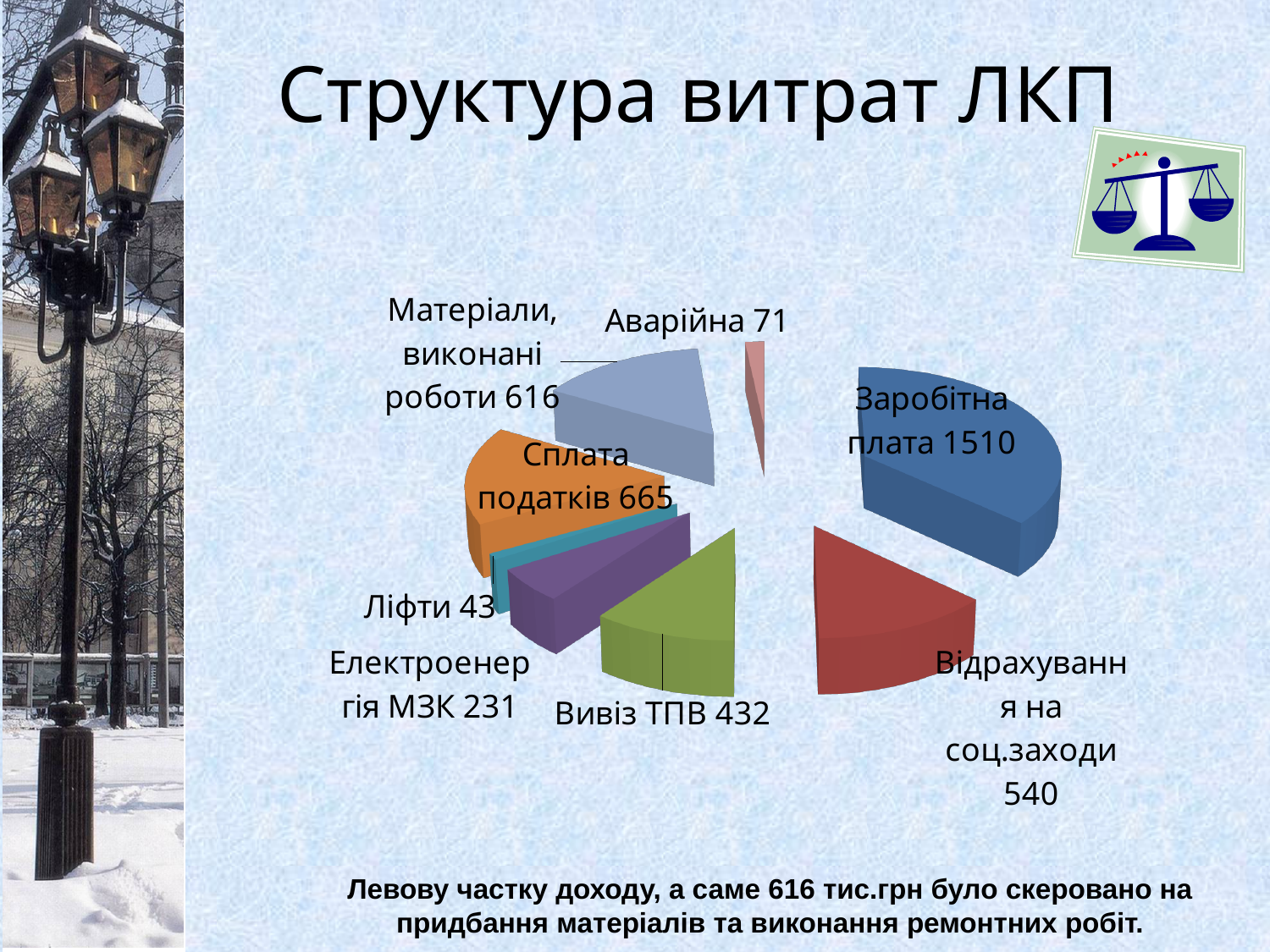
What kind of chart is shown on the slide? Pie chart Which is larger: Сплата податків or Матеріали, виконані роботи? Сплата податків Which category has the largest slice of the pie? Заробітна плата What is the value for Сплата податків? 665 What is the value for Вивіз ТПВ? 432 What is the value for Аварійна? 71 How many slices does the pie chart have? 8 What is the difference between Електроенергія МЗК and Ліфти? 188 What is the difference between Заробітна плата and Відрахування на соц.заходи? 970 Which category has the smallest slice of the pie? Ліфти What is the title of the chart on the slide? Структура витрат ЛКП What is the value for Заробітна плата? 1510